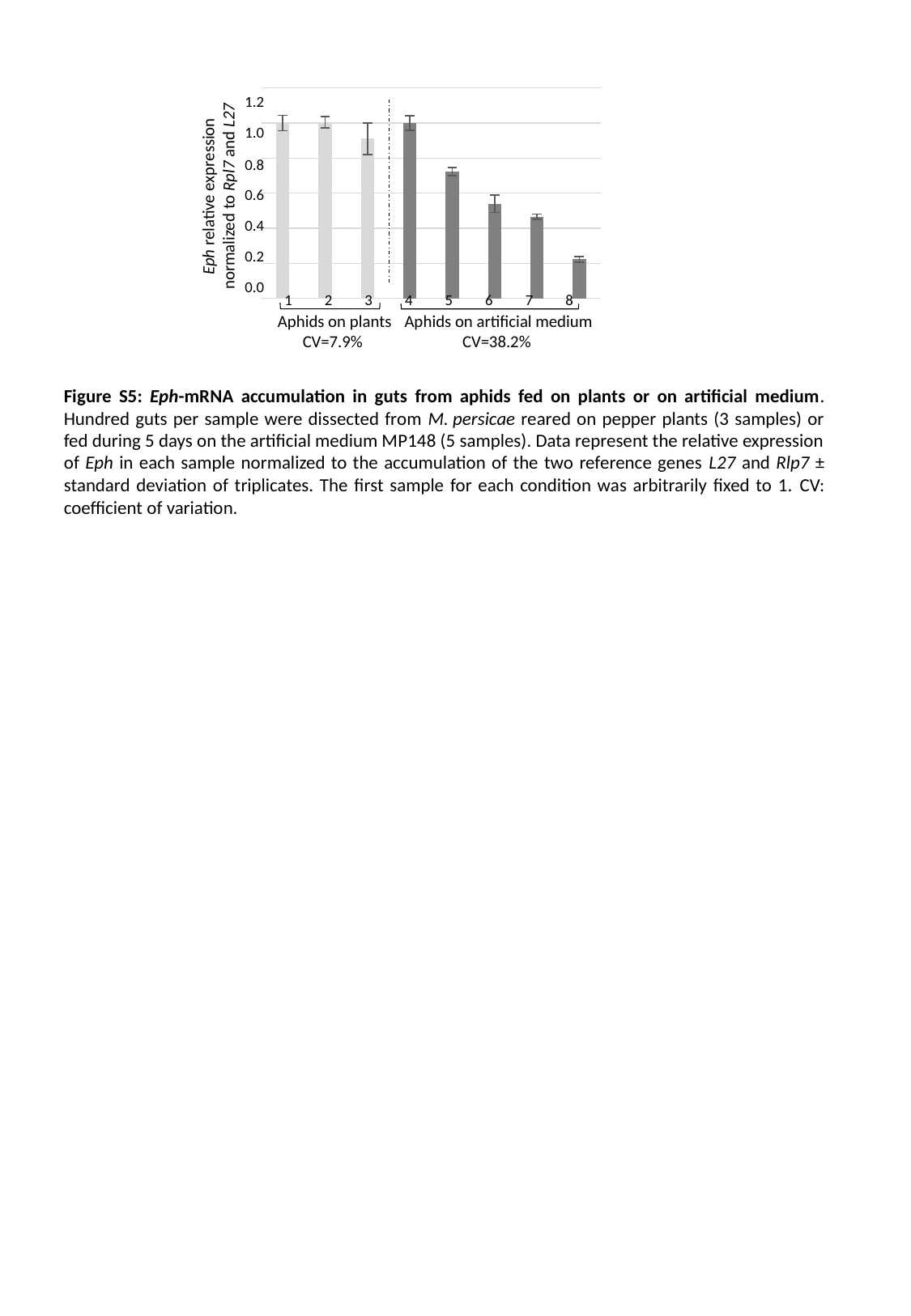
How many samples are in the 'Aphids on artificial medium' group? 5 Do the values rise or fall from sample 4 to sample 8 in the 'Aphids on artificial medium' group? fall Is the value for sample 8 greater or less than 0.4? less How many bars (samples) are plotted in the chart? 8 What is the coefficient of variation (CV) shown for the 'Aphids on artificial medium' group? CV=38.2% Which has the higher Eph relative expression, sample 5 or sample 7? sample 5 Is the value for sample 1 greater or less than 0.8? greater What is the coefficient of variation (CV) shown for the 'Aphids on plants' group? CV=7.9% Is the value for sample 7 greater or less than 0.6? less What kind of chart is shown on the slide? bar chart Which sample has the lowest Eph relative expression? 8